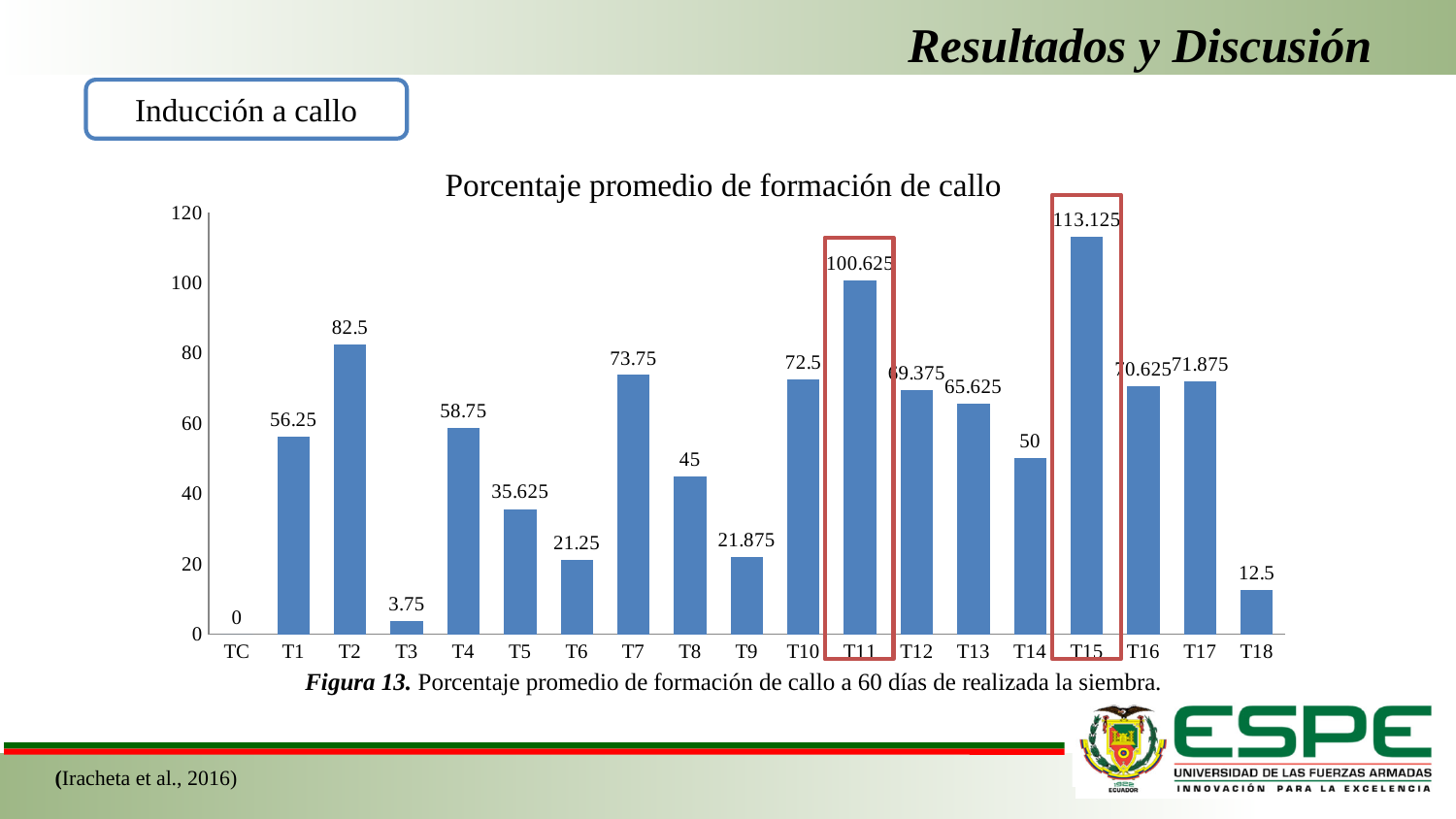
How many categories are shown on the x axis of the chart? 19 What is the value for T5 in the chart? 35.625 Which has a larger value, T2 or T4? T2 Is the value for T14 greater or less than 40? greater What is the value for T9 in the chart? 21.875 What kind of chart is shown on the slide? bar chart What is the difference between the values for T2 and T1? 26.25 Which two bars are outlined with red boxes in the chart? T11 and T15 Which category has the lowest value in the chart? TC What is the difference between the values for T15 and T11? 12.5 Which category has the highest value in the chart? T15 What is the value for T15 in the chart? 113.125